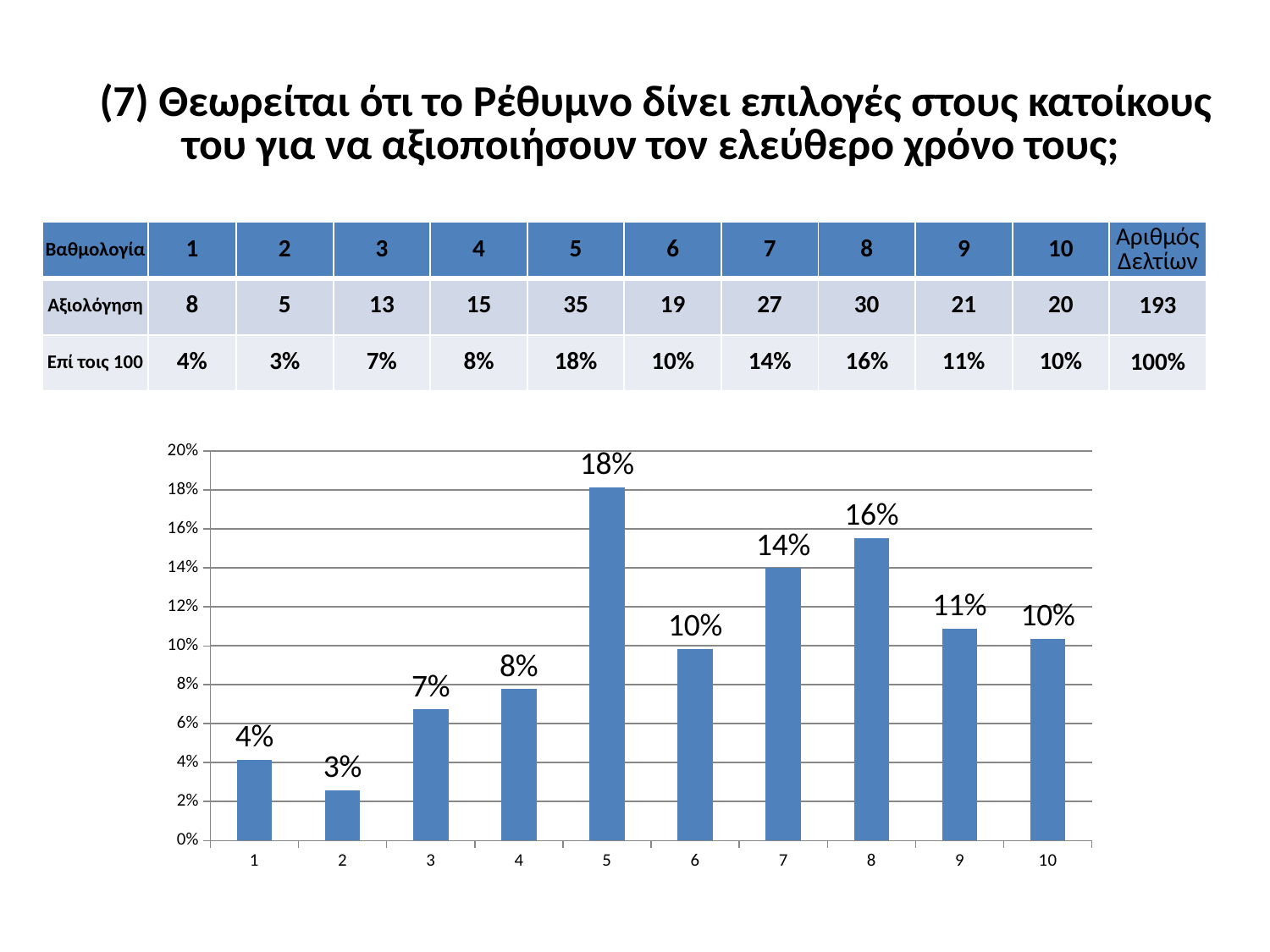
Which category has the lowest value in the bar chart? 2 What is the highest value shown on the y axis of the bar chart? 20% How many categories are shown on the x axis of the bar chart? 10 Is the value for category 6 in the bar chart greater or less than 12%? less What is the difference between the values for category 5 and category 8 in the bar chart? 2% What is the difference between the values for category 7 and category 1 in the bar chart? 10% What is the value shown for category 5 in the bar chart? 18% What kind of chart is shown on the slide? bar chart What is the value shown for category 8 in the bar chart? 16% Which category has the highest value in the bar chart? 5 Which has a larger value in the bar chart, category 7 or category 9? 7 What is the value shown for category 2 in the bar chart? 3%